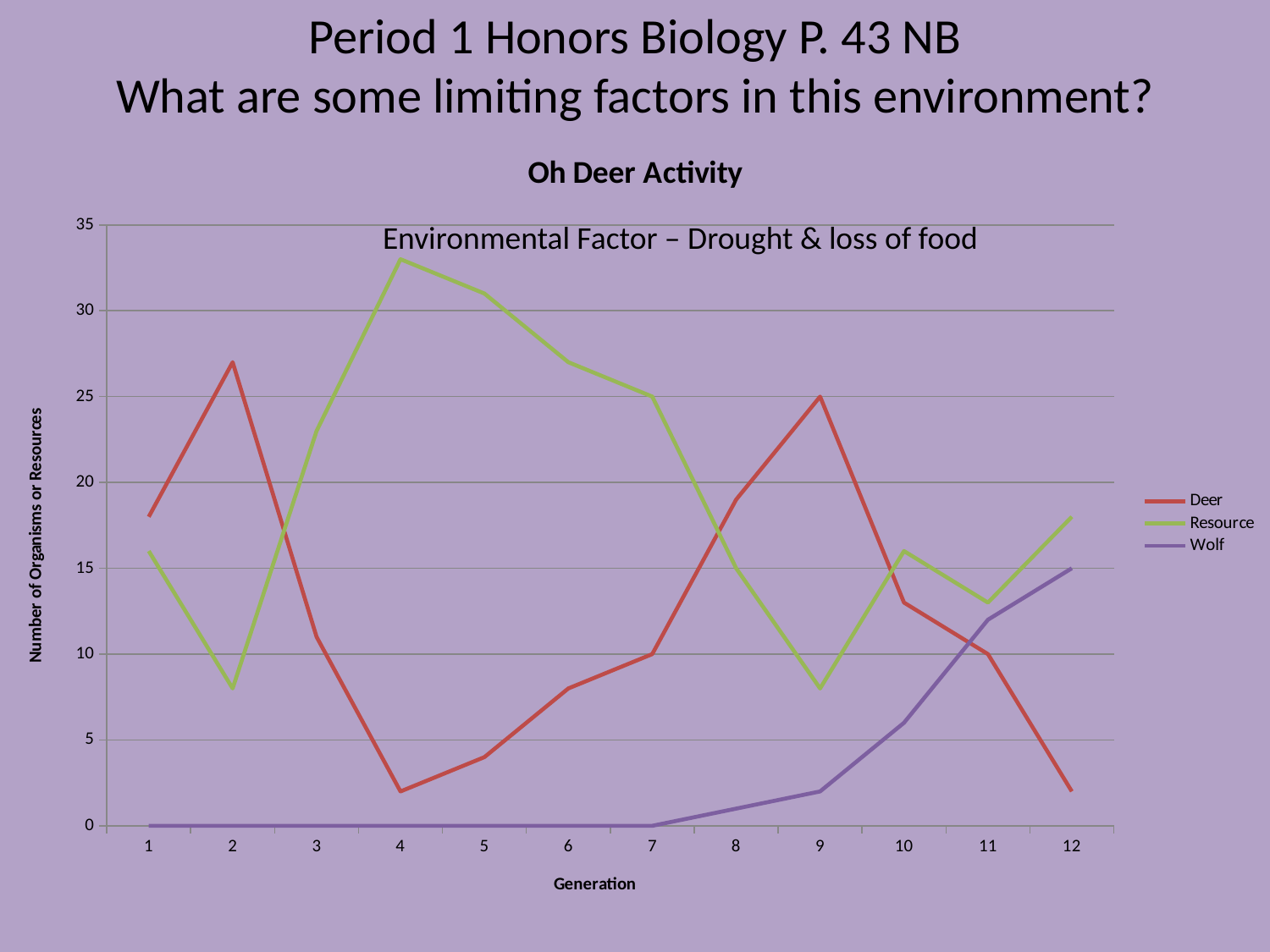
Does the Wolf series rise or fall from generation 7 to generation 12? Rise Is the Resource value at generation 4 greater or less than 30? greater What is the Wolf value at generation 12? 15 What type of chart is shown on the slide? Line chart What is the Deer value at generation 9? 25 What is the Wolf value at generation 1? 0 At which generation does the Resource series reach its highest value? 4 How many series does the legend list? 3 What is the title of the chart? Oh Deer Activity At generation 12, which is larger: Deer or Wolf? Wolf Is the Deer value at generation 4 greater or less than 5? less How many generations are plotted along the x axis? 12